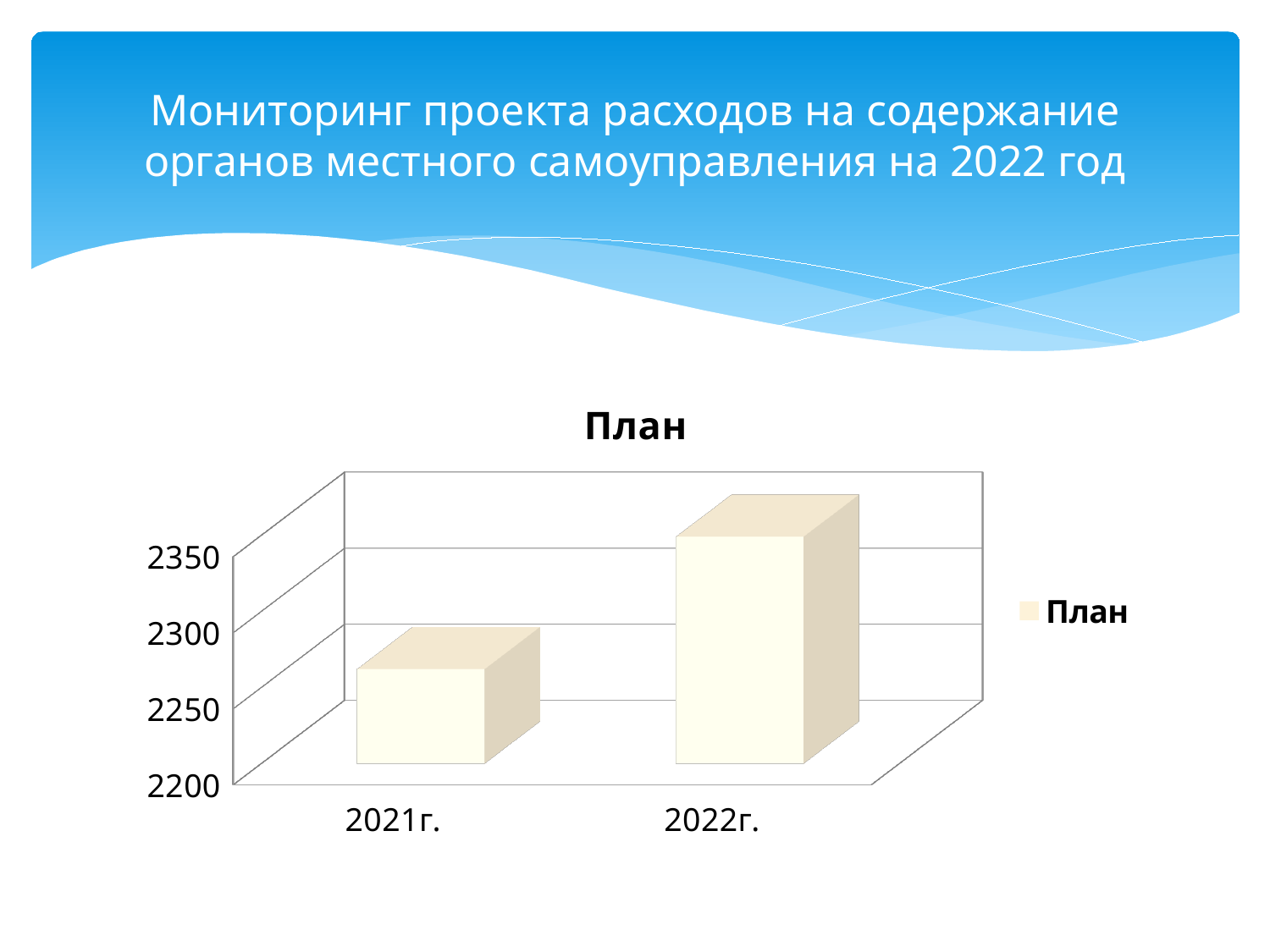
Do the values rise or fall from 2021г. to 2022г.? rise How many categories are shown on the x axis of the chart? 2 Is the value for 2021г. greater or less than 2300? less Which year has the lowest value in the chart? 2021г. Which year has the highest value in the chart? 2022г. What series name appears in the chart legend? План What is the title of the chart? План Is the value for 2022г. greater or less than 2300? greater Is the value for 2022г. greater or less than 2250? greater Which is larger, the value for 2021г. or the value for 2022г.? 2022г. What kind of chart is shown on the slide? bar chart How many series does the chart legend list? 1